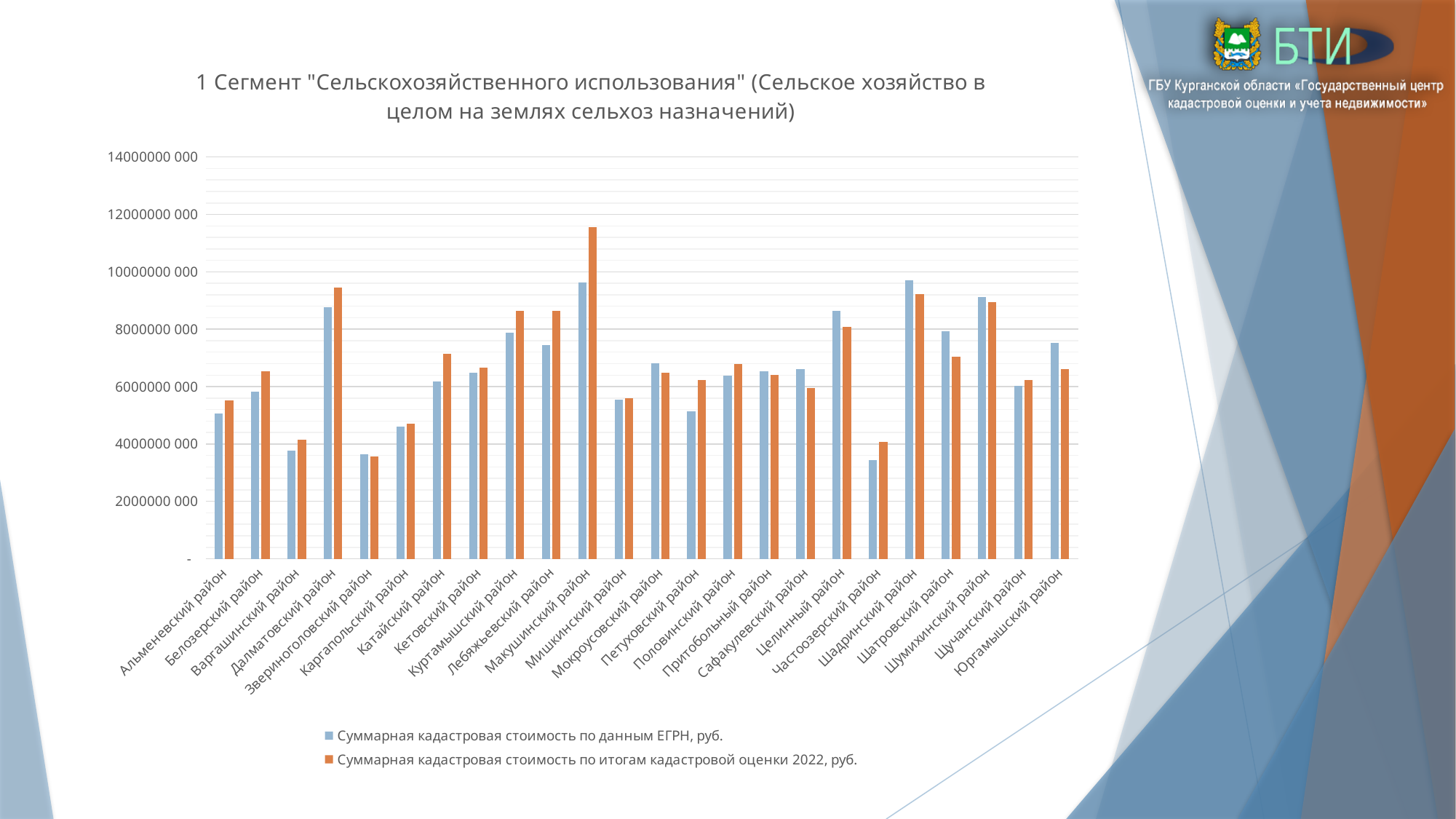
Which district has the lowest value for the series "Суммарная кадастровая стоимость по итогам кадастровой оценки 2022, руб."? Звериноголовский район For Далматовский район, which series has the larger value: "по данным ЕГРН" or "по итогам кадастровой оценки 2022"? по итогам кадастровой оценки 2022 What is the first legend entry of the chart? Суммарная кадастровая стоимость по данным ЕГРН, руб. Is the value for Частоозерский район in the series "Суммарная кадастровая стоимость по данным ЕГРН, руб." greater or less than 4000000 000? less How many series does the legend list? 2 Is the value for Макушинский район in the series "Суммарная кадастровая стоимость по итогам кадастровой оценки 2022, руб." greater or less than 10000000 000? greater Which district has the highest value for the series "Суммарная кадастровая стоимость по итогам кадастровой оценки 2022, руб."? Макушинский район How many districts (categories) are shown along the x axis? 24 What colour are the bars for the series "Суммарная кадастровая стоимость по итогам кадастровой оценки 2022, руб."? Orange Is the value for Далматовский район in the series "Суммарная кадастровая стоимость по данным ЕГРН, руб." greater or less than 8000000 000? greater For Шатровский район, which series has the larger value: "по данным ЕГРН" or "по итогам кадастровой оценки 2022"? по данным ЕГРН What kind of chart is shown on the slide? Bar chart